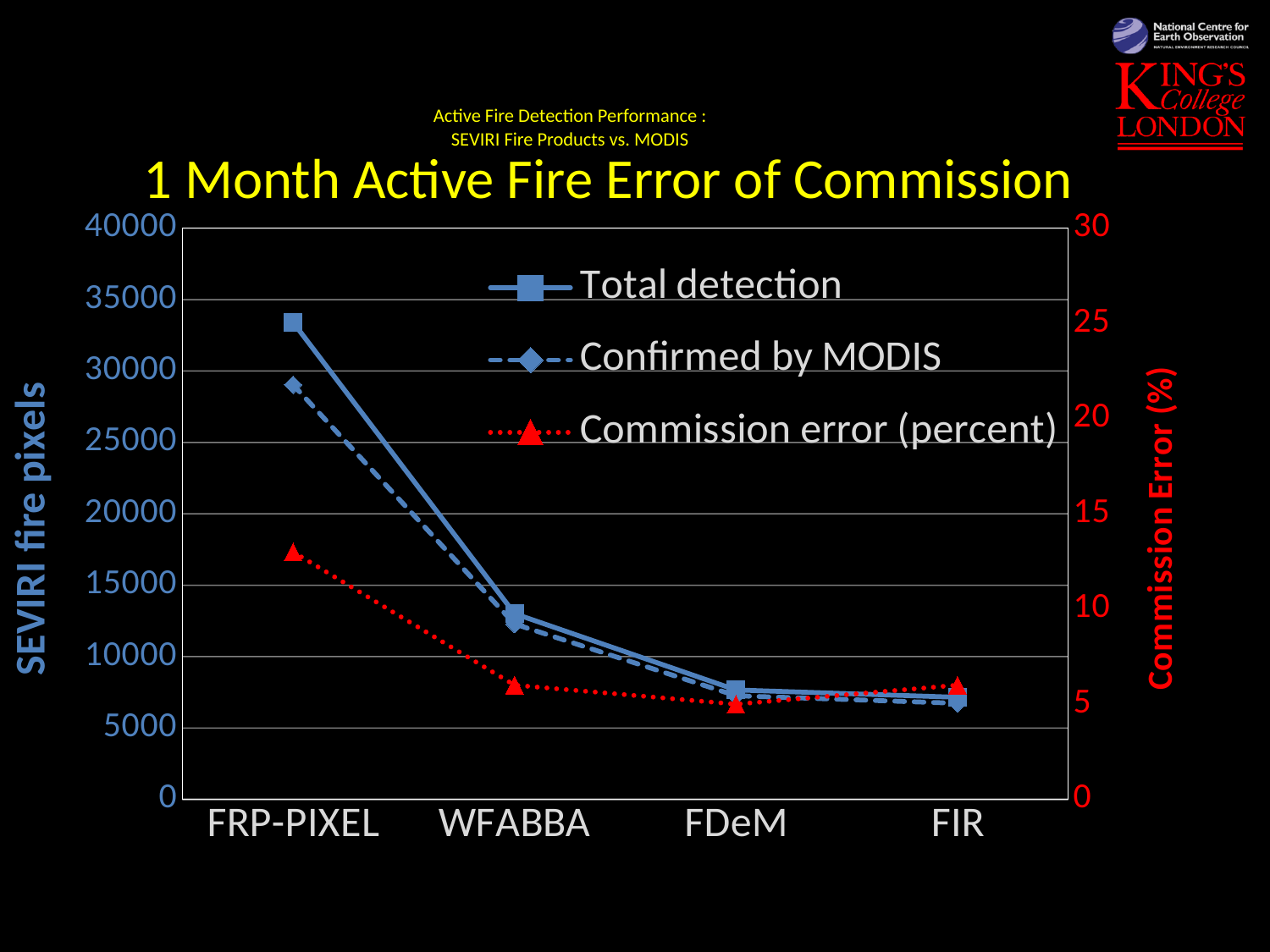
Which category has the highest Total detection value? FRP-PIXEL How many categories are shown on the x axis? 4 Which is larger, the Total detection value for FRP-PIXEL or for WFABBA? FRP-PIXEL Is the Commission error (percent) for FRP-PIXEL greater or less than 10? greater Is the Total detection value for WFABBA greater or less than 15000? less Is the Commission error (percent) for WFABBA greater or less than 10? less Does the Total detection series rise or fall from FRP-PIXEL to FIR? fall What kind of chart is shown on the slide? line chart Which category has the highest Commission error (percent)? FRP-PIXEL How many series does the legend list? 3 What is the label of the right-hand vertical axis? Commission Error (%)